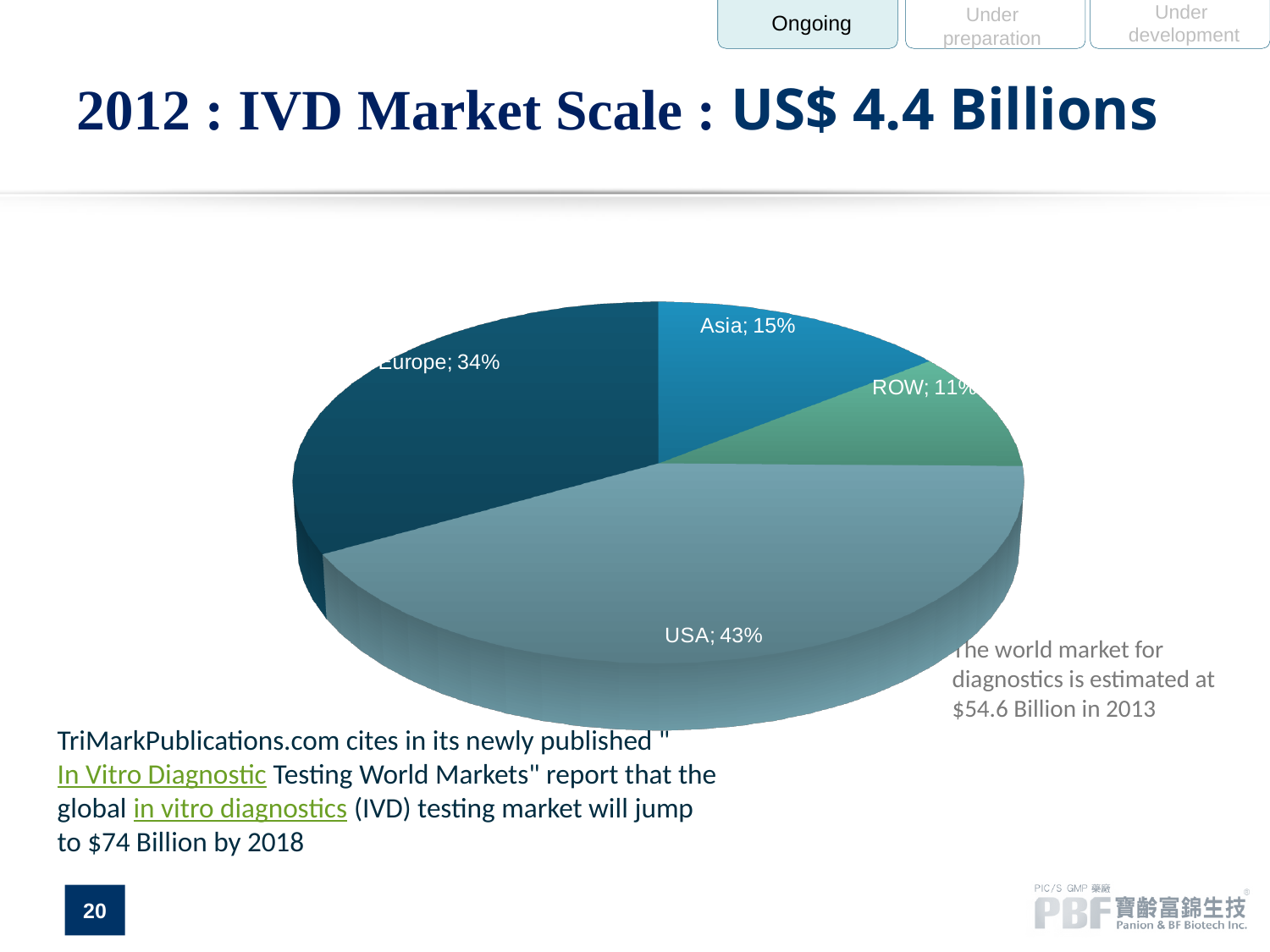
Which region has the largest share of the IVD market? USA What share of the IVD market does Asia represent? 15% What is the combined share of Asia and ROW? 26% How many slices does the pie chart have? 4 What kind of chart is shown on the slide? pie chart What is the difference in percentage points between the USA and Europe shares? 9 What is the title of the slide containing the pie chart? 2012 : IVD Market Scale : US$ 4.4 Billions What share of the IVD market does ROW represent? 11% Which region has the smallest share of the IVD market? ROW What share of the IVD market does Europe represent? 34% What share of the IVD market does the USA slice represent? 43% Which has a larger share of the IVD market, Asia or ROW? Asia